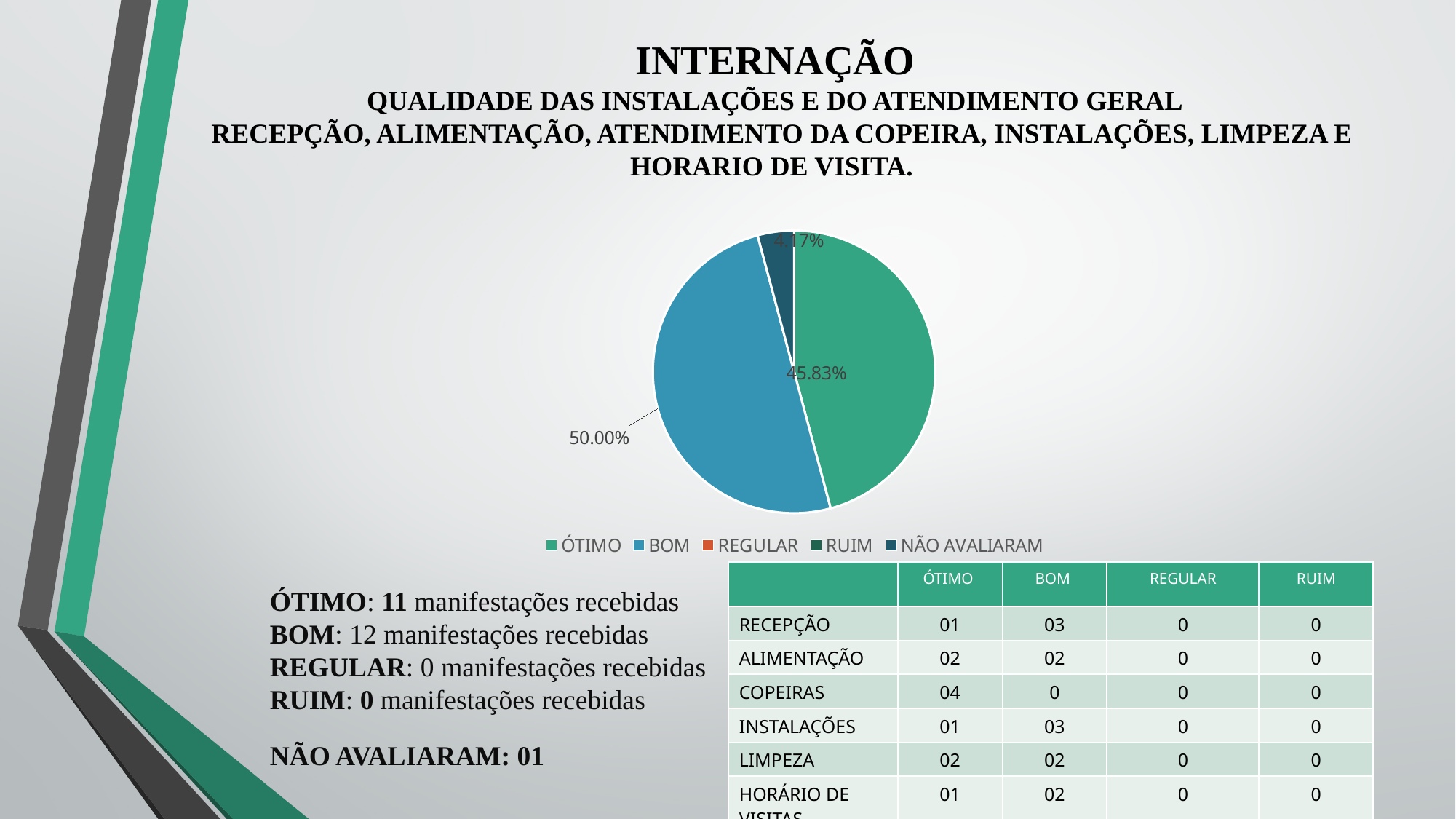
What is the difference between the BOM share and the ÓTIMO share? 4.17% What is the main title shown above the pie chart? INTERNAÇÃO How many slices with a visible share are shown in the pie chart? 3 Which category has the largest slice in the pie chart? BOM Which category has the smallest visible slice in the pie chart? NÃO AVALIARAM What share of the pie does the BOM slice represent? 50.00% Which legend entry is shown in green? ÓTIMO What share of the pie does the NÃO AVALIARAM slice represent? 4.17% Which slice is larger, ÓTIMO or BOM? BOM How many entries does the legend of the pie chart list? 5 What share of the pie does the ÓTIMO slice represent? 45.83% What kind of chart is shown on the slide? pie chart